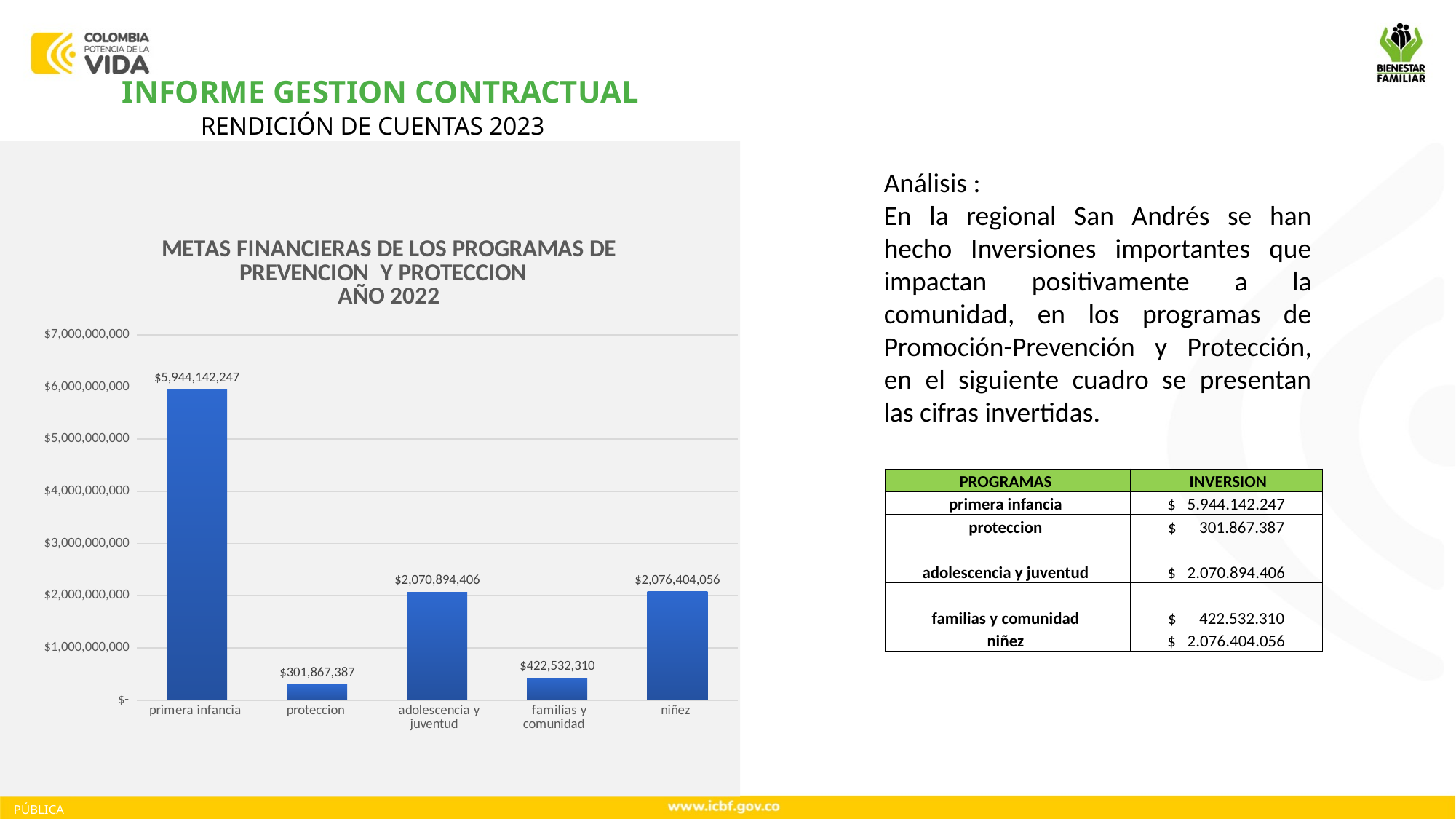
Which category has the lowest value? proteccion What is the value for familias y comunidad? $422,532,310 Is the value for primera infancia greater or less than $5,000,000,000? greater What is the value for primera infancia? $5,944,142,247 What is the difference between the values for primera infancia and proteccion? $5,642,274,860 Which category has the highest value? primera infancia What is the value for proteccion? $301,867,387 What kind of chart is shown on the slide? bar chart What is the value for niñez? $2,076,404,056 What is the difference between the values for familias y comunidad and proteccion? $120,664,923 How many categories are shown on the x axis? 5 Which is larger, the value for familias y comunidad or the value for proteccion? familias y comunidad